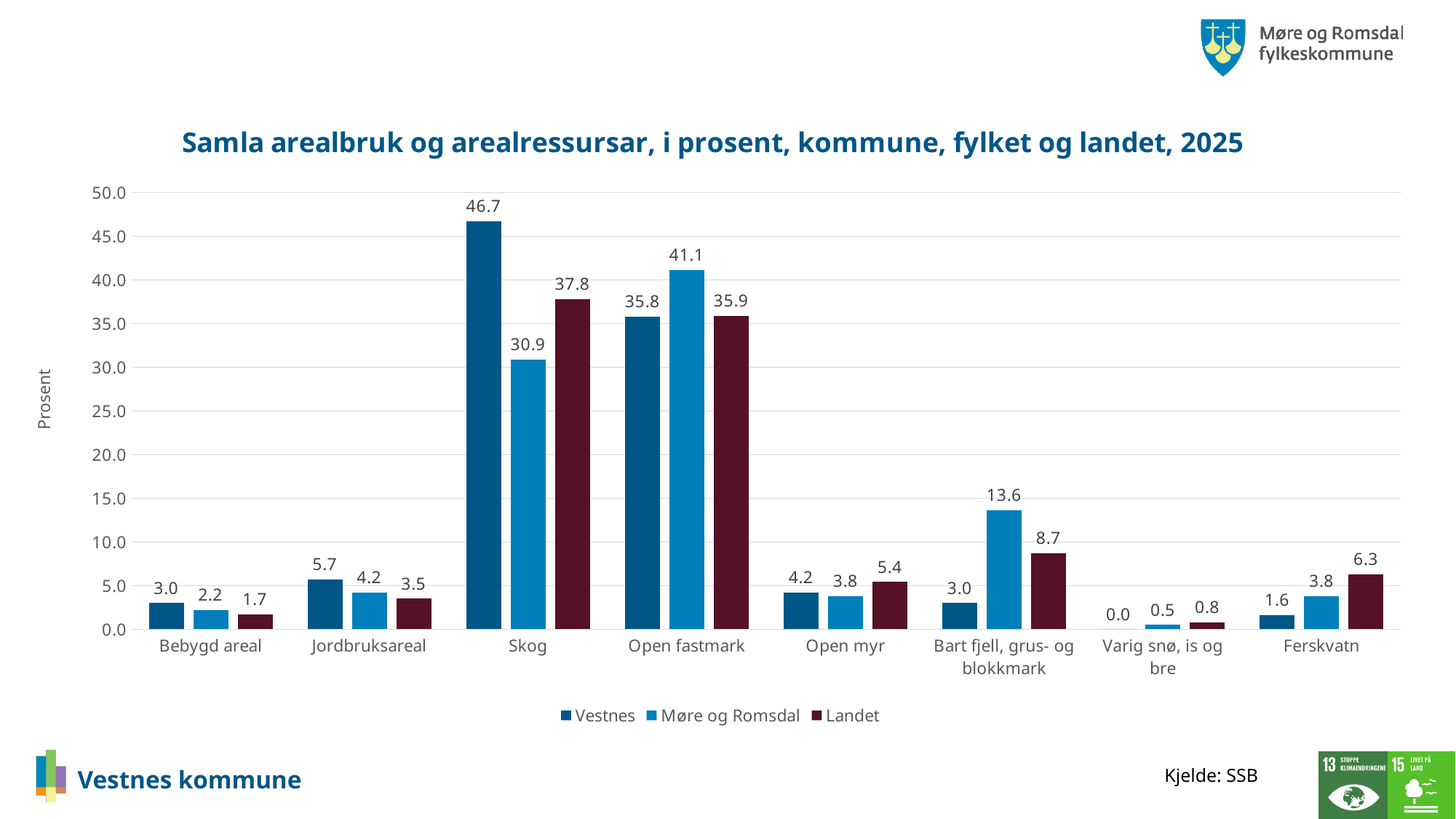
Which category has the highest value for Vestnes? Skog How many series does the legend list? 3 Which category has the lowest value for Møre og Romsdal? Varig snø, is og bre What is the value for Landet in the Bart fjell, grus- og blokkmark category? 8.7 What is the title of the chart? Samla arealbruk og arealressursar, i prosent, kommune, fylket og landet, 2025 What is the value for Vestnes in the Skog category? 46.7 What kind of chart is shown on the slide? Bar chart What is the difference between the Vestnes and Møre og Romsdal values for Skog? 15.8 What is the value for Møre og Romsdal in the Open fastmark category? 41.1 Is the value for Landet in the Skog category greater or less than 35.0? greater Which is larger for Ferskvatn: the value for Vestnes or the value for Landet? Landet How many categories are shown on the x axis? 8